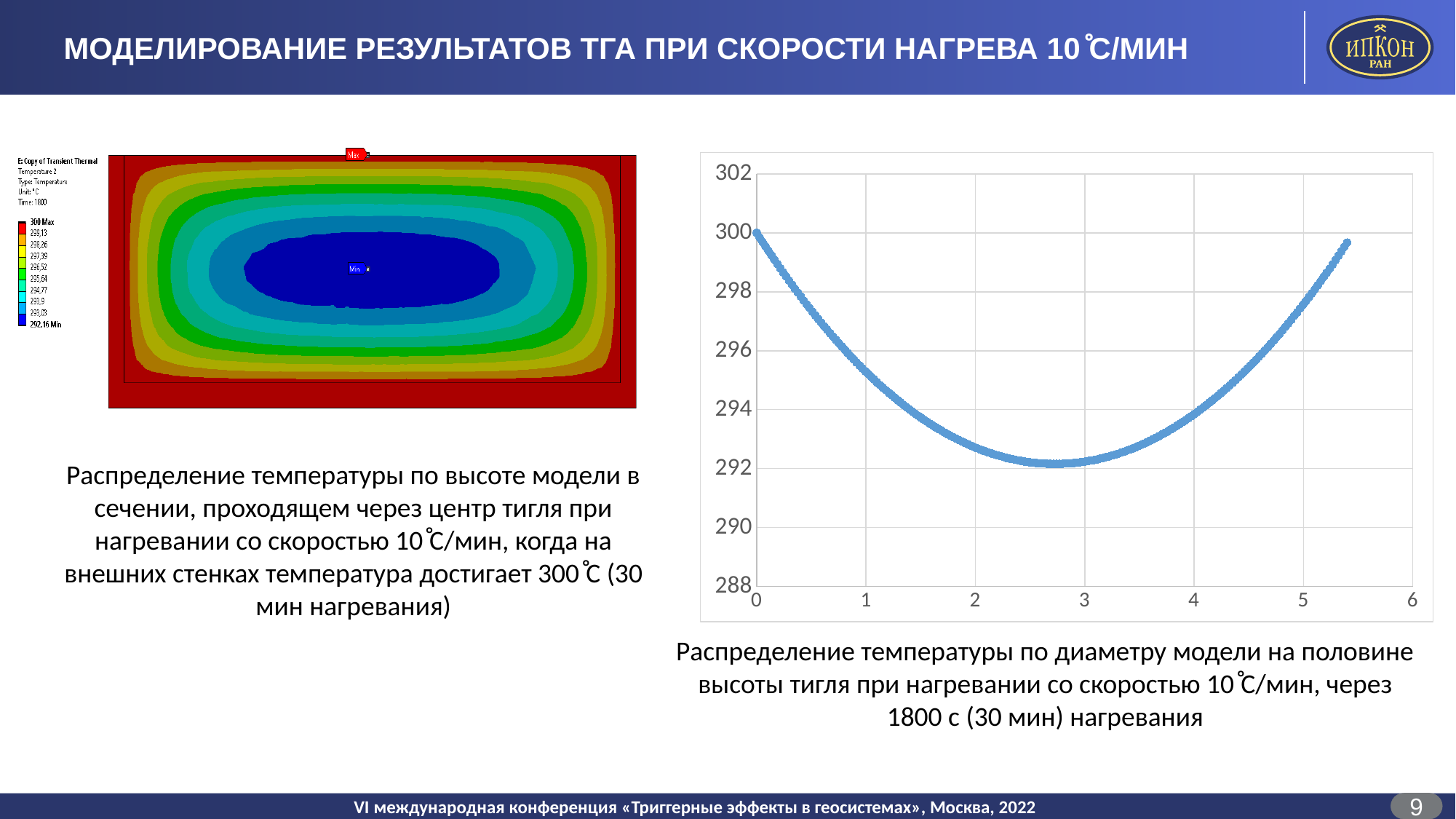
In the right-hand chart, which is larger: the value at x = 1 or the value at x = 4? the value at x = 1 In the right-hand chart, is the value at x = 3 greater or less than 294? less In the right-hand chart, is the value at x = 4 greater or less than 292? greater In the right-hand chart, is the value at x = 5 greater or less than 296? greater In the right-hand chart, do the values rise or fall as x goes from 3 to 5? rise In the right-hand chart, which is larger: the value at x = 0 or the value at x = 3? the value at x = 0 In the right-hand chart, what is the highest tick shown on the vertical axis? 302 What kind of chart is shown on the right side of the slide? scatter chart In the right-hand chart, do the values rise or fall as x goes from 0 to 2? fall In the right-hand chart, what is the value at x = 0? 300